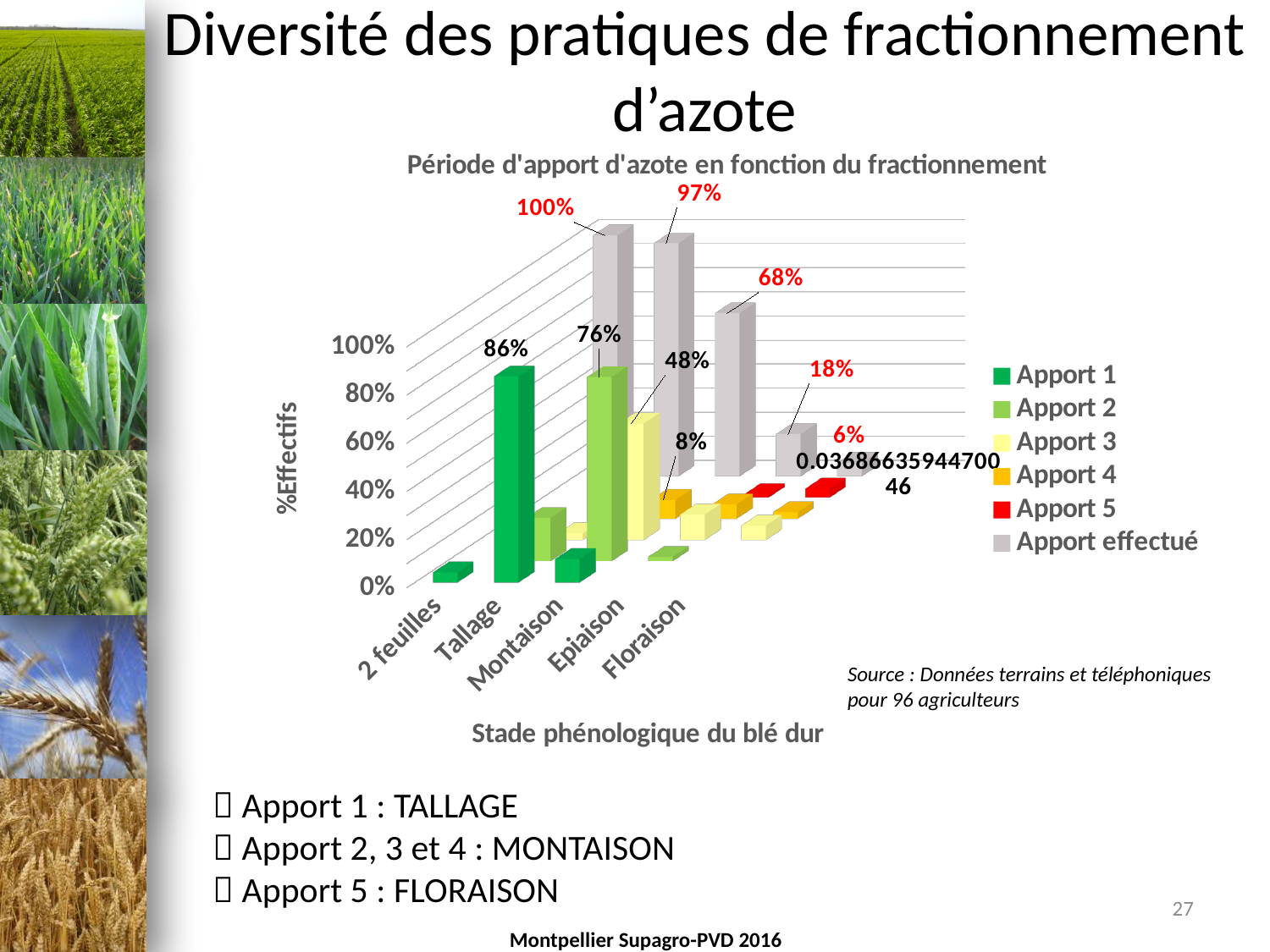
What kind of chart is shown on the slide? bar chart What is the title of the chart? Période d'apport d'azote en fonction du fractionnement How many phenological stages are shown on the x axis of the chart? 5 How many series does the chart legend list? 6 What is the value for Apport 1 at the Tallage stage? 86% What is the value for Apport 3 at the Montaison stage? 48% What is the value for Apport 2 at the Montaison stage? 76% What is the value for Apport 4 at the Montaison stage? 8% What is the difference between the Apport 2 value (76%) and the Apport 3 value (48%) at Montaison? 28% What is the largest value labelled in red on the chart? 100% At the Montaison stage, which is larger: Apport 2 or Apport 3? Apport 2 What is the smallest value labelled in red on the chart? 6%